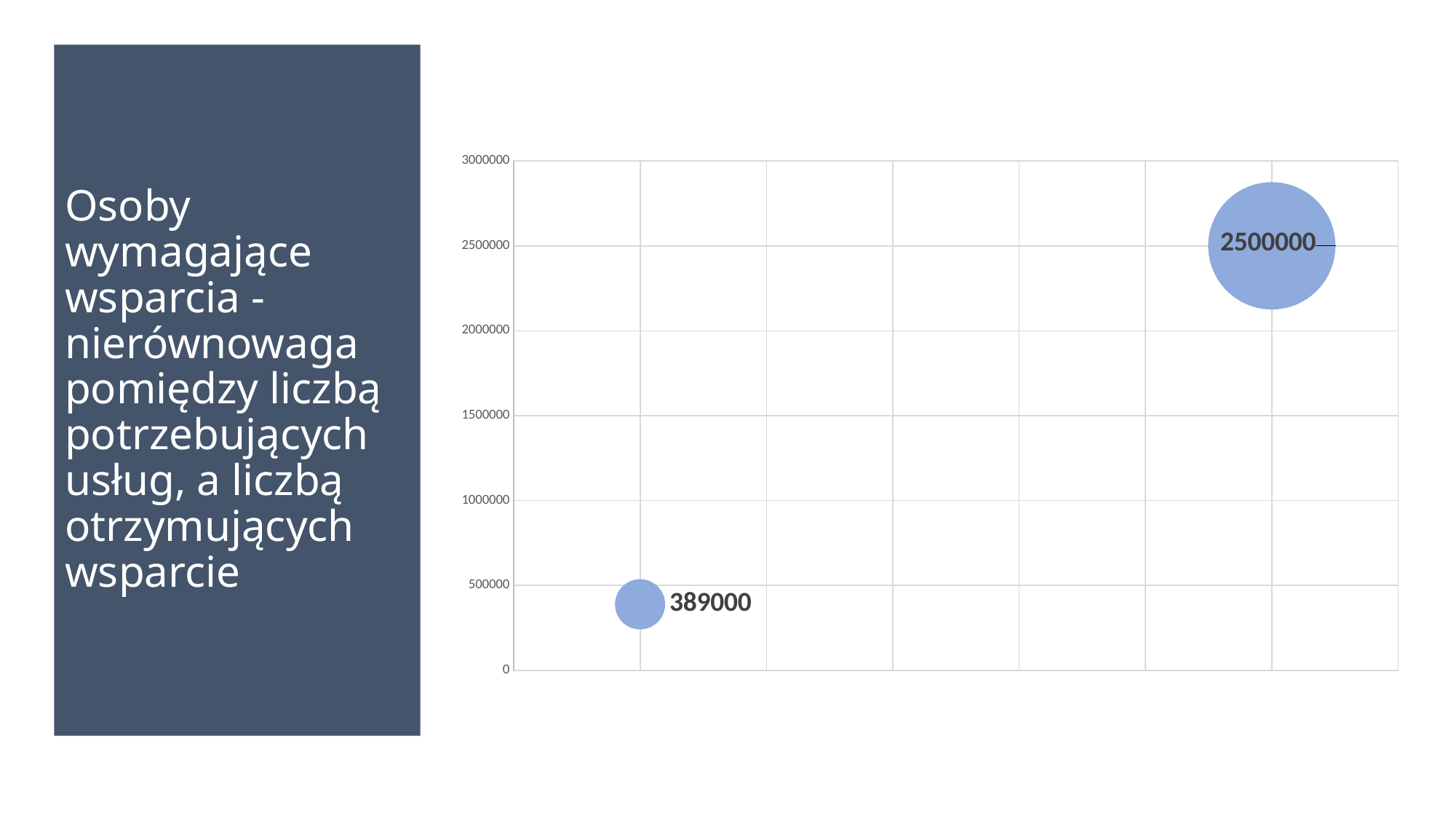
Which bubble has the larger value, the one on the left or the one on the right? the one on the right How many bubbles are plotted on the chart? 2 What is the difference between the two labelled values on the chart? 2111000 What is the highest tick value shown on the vertical axis of the chart? 3000000 What colour are the bubbles on the chart? blue What is the highest value labelled on the chart? 2500000 What is the value labelled on the larger bubble in the upper right of the chart? 2500000 What kind of chart is shown on the slide? bubble chart Is the value of the upper-right bubble greater or less than 2000000? greater What is the lowest value labelled on the chart? 389000 Is the value of the lower-left bubble greater or less than 500000? less What is the value labelled on the smaller bubble in the lower left of the chart? 389000